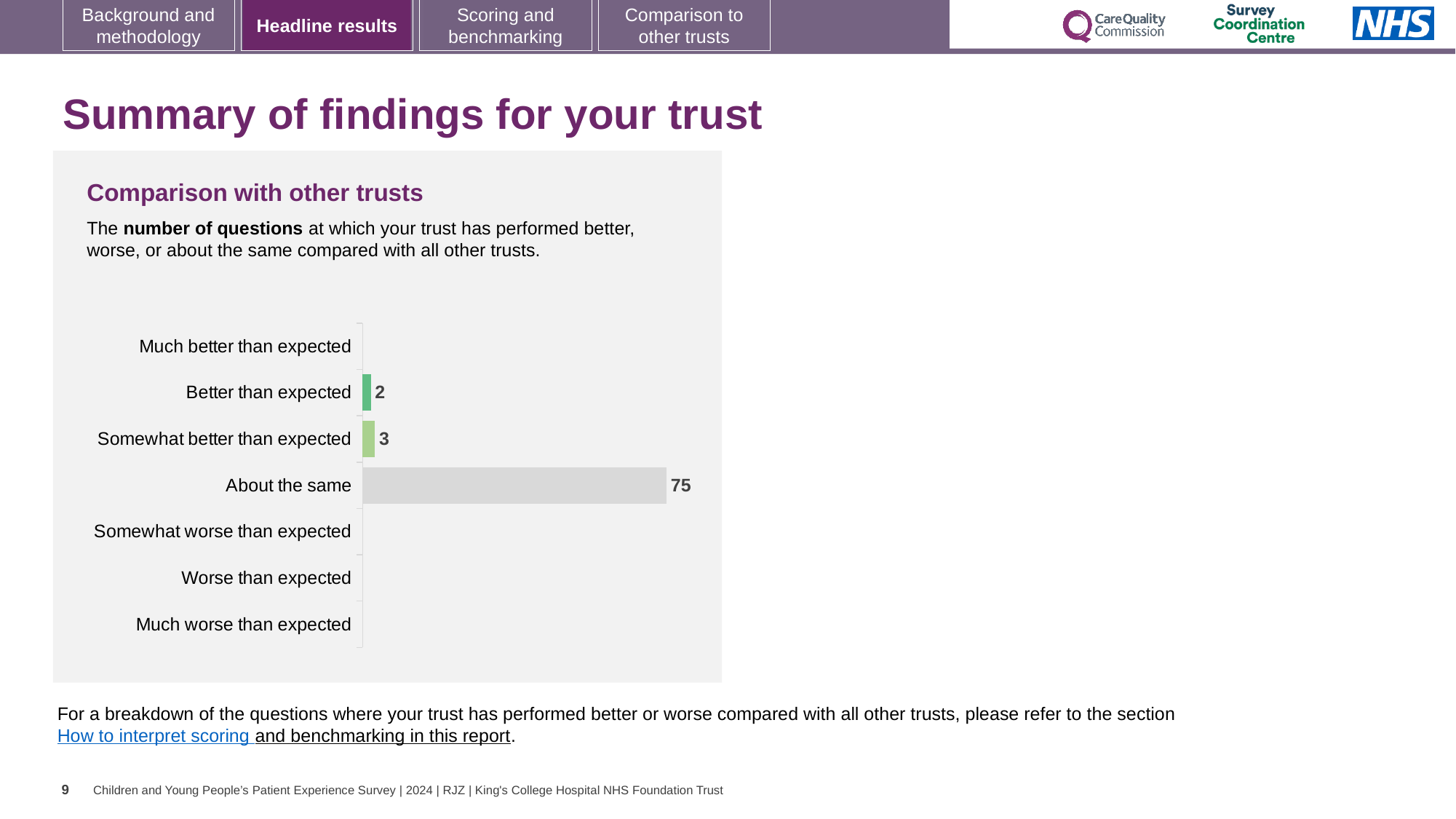
What colour is the bar for 'About the same'? Grey What is the value for 'About the same'? 75 What is the value for 'Somewhat better than expected'? 3 What is the difference between 'Somewhat better than expected' and 'Better than expected'? 1 How many categories have a visible bar with a data label? 3 What is the title of the chart section? Comparison with other trusts How many categories are listed on the chart's axis? 7 What is the difference between 'About the same' and 'Somewhat better than expected'? 72 Which is larger, 'Better than expected' or 'Somewhat better than expected'? Somewhat better than expected What is the value for 'Better than expected'? 2 What kind of chart is shown on the slide? Bar chart Which category has the highest value? About the same